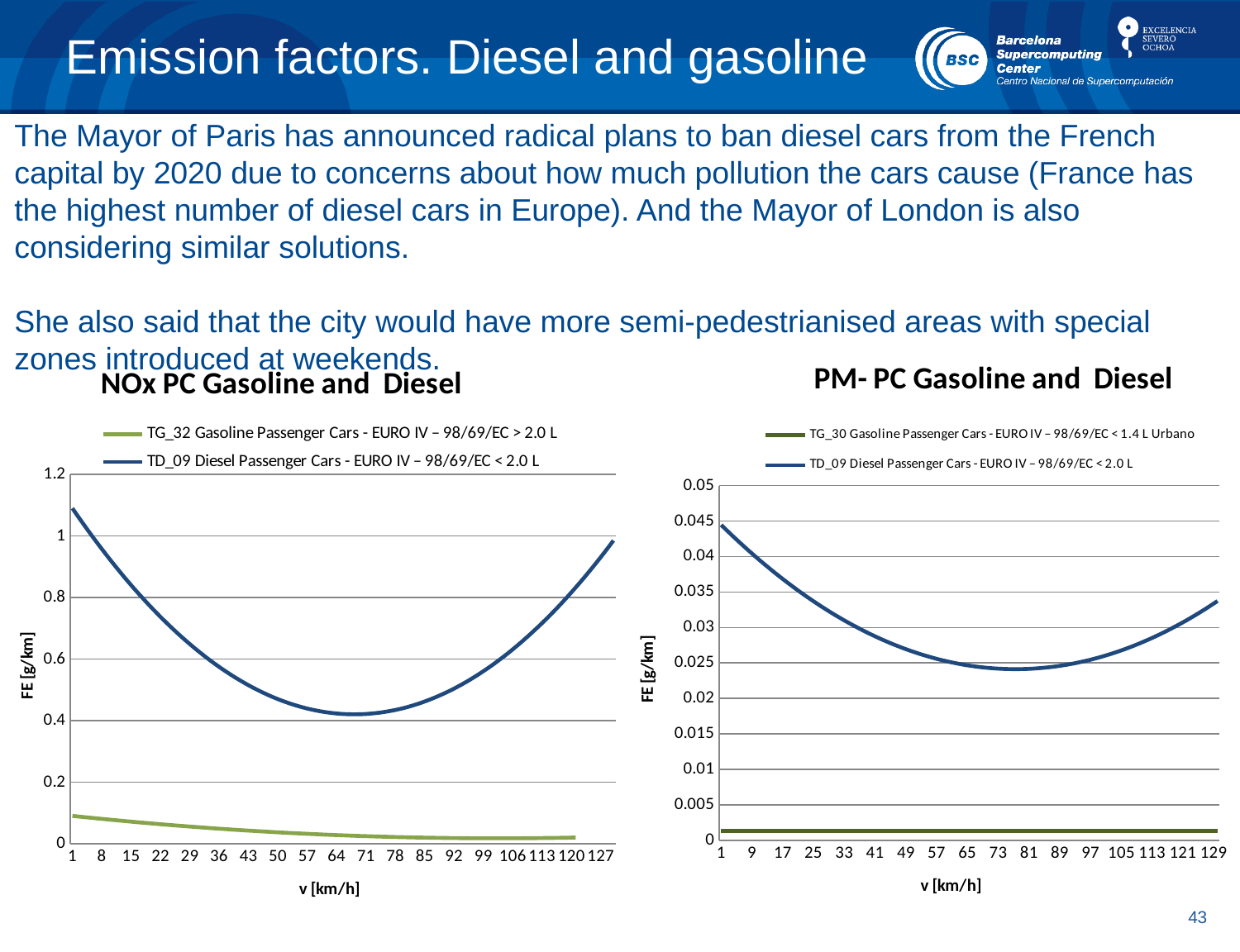
How many series does the legend of the PM- PC Gasoline and Diesel chart list? 2 In the NOx PC Gasoline and Diesel chart, at v = 1 km/h, which series has the higher value: TD_09 Diesel or TG_32 Gasoline? TD_09 Diesel What is the y-axis label of the PM- PC Gasoline and Diesel chart? FE [g/km] In the PM- PC Gasoline and Diesel chart, is the lowest value of the TD_09 Diesel series greater or less than 0.03? less What kind of chart is the NOx PC Gasoline and Diesel chart? line chart In the PM- PC Gasoline and Diesel chart, which series has the higher values across all speeds: TD_09 Diesel or TG_30 Gasoline? TD_09 Diesel In the NOx PC Gasoline and Diesel chart, which series is plotted in green? TG_32 Gasoline Passenger Cars - EURO IV – 98/69/EC > 2.0 L In the NOx PC Gasoline and Diesel chart, is the value of the TD_09 Diesel series at v = 1 km/h greater or less than 1? greater In the NOx PC Gasoline and Diesel chart, does the TG_32 Gasoline series rise or fall as speed increases along the x axis? fall In the PM- PC Gasoline and Diesel chart, is the value of the TD_09 Diesel series at v = 1 km/h greater or less than 0.04? greater